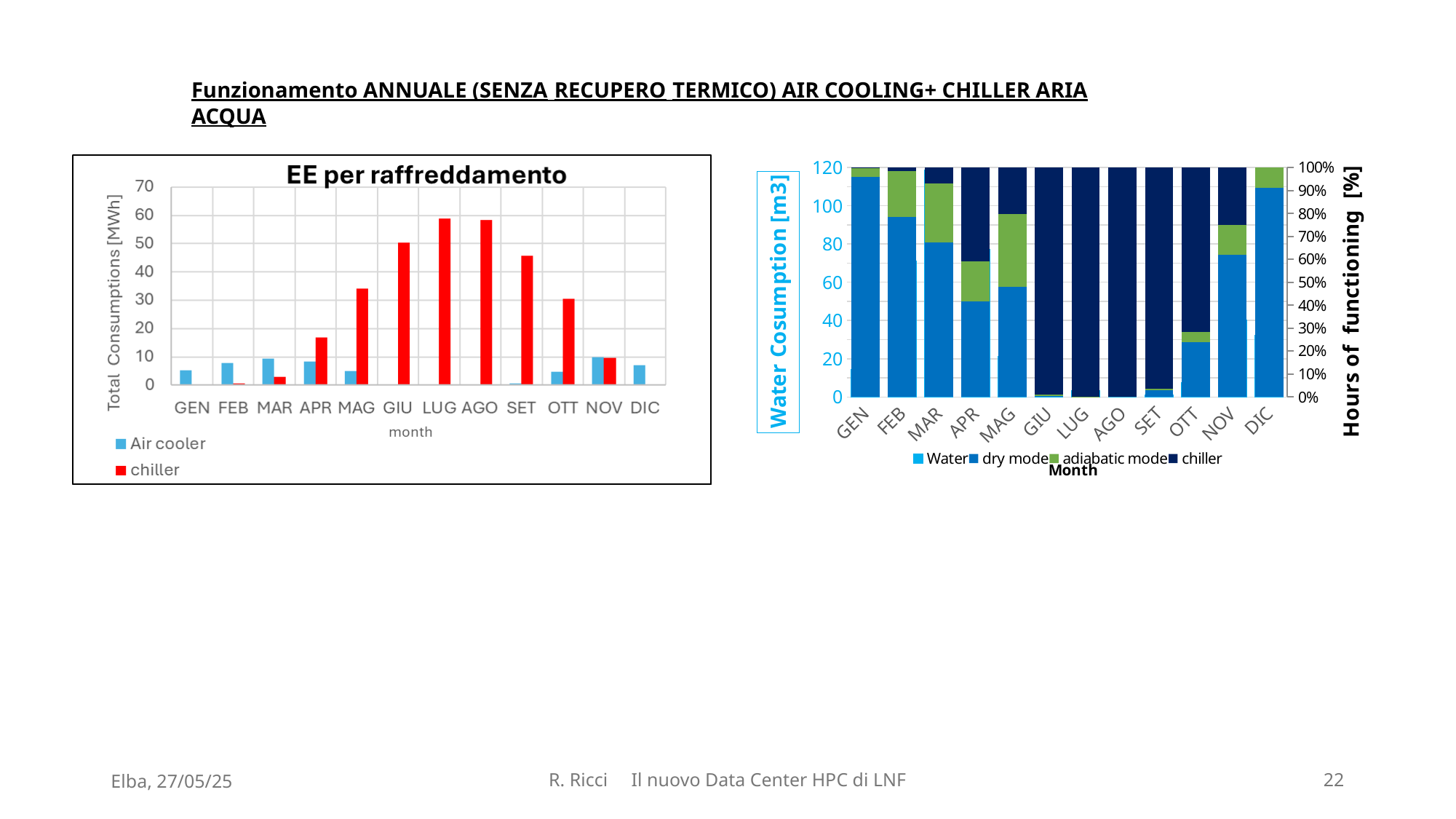
On the left chart 'EE per raffreddamento', is the chiller value for OTT greater or less than 20? greater On the right chart, is the chiller share for OTT greater or less than 50%? greater On the left chart 'EE per raffreddamento', how many series does the legend list? 2 On the left chart titled 'EE per raffreddamento', what kind of chart is shown? bar chart On the left chart 'EE per raffreddamento', is the chiller value for MAG greater or less than 40? less On the right chart, what is the label of the right-hand vertical axis? Hours of functioning [%] On the left chart 'EE per raffreddamento', how many months are shown on the x axis? 12 On the left chart 'EE per raffreddamento', which is larger: the chiller value for GIU or the chiller value for SET? GIU On the right chart, how many series does the legend list? 4 On the left chart 'EE per raffreddamento', does the chiller series rise or fall from GEN to LUG? rise On the left chart 'EE per raffreddamento', what is the label of the x axis? month